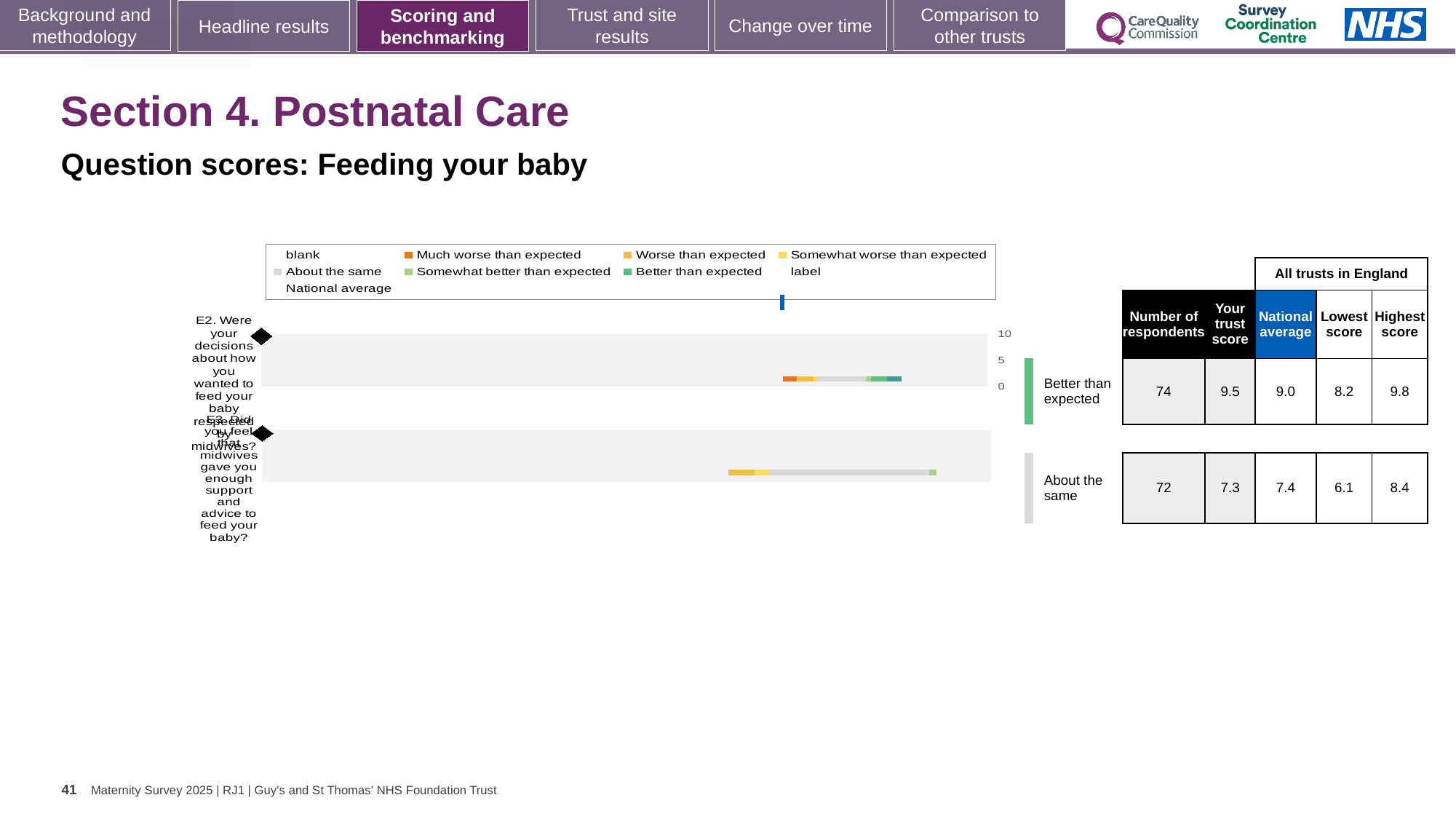
Which is larger for E2: the trust score or the national average? Trust score What is the highest score among all trusts in England for E2? 9.8 What is the national average for E2 (decisions about feeding your baby respected by midwives)? 9.0 How many respondents answered question E3? 72 What is the lowest score among all trusts in England for E3? 6.1 How many more respondents answered E2 than E3? 2 What benchmark category is shown for question E3? About the same What is the trust score for E3 (midwives gave you enough support and advice to feed your baby)? 7.3 What is the trust score for E2 (decisions about how you wanted to feed your baby respected by midwives)? 9.5 What is the difference between the highest and lowest scores for E3 across all trusts in England? 2.3 What kind of chart is used to show the question scores for Feeding your baby? Bar chart How many questions are plotted in the Feeding your baby chart? 2